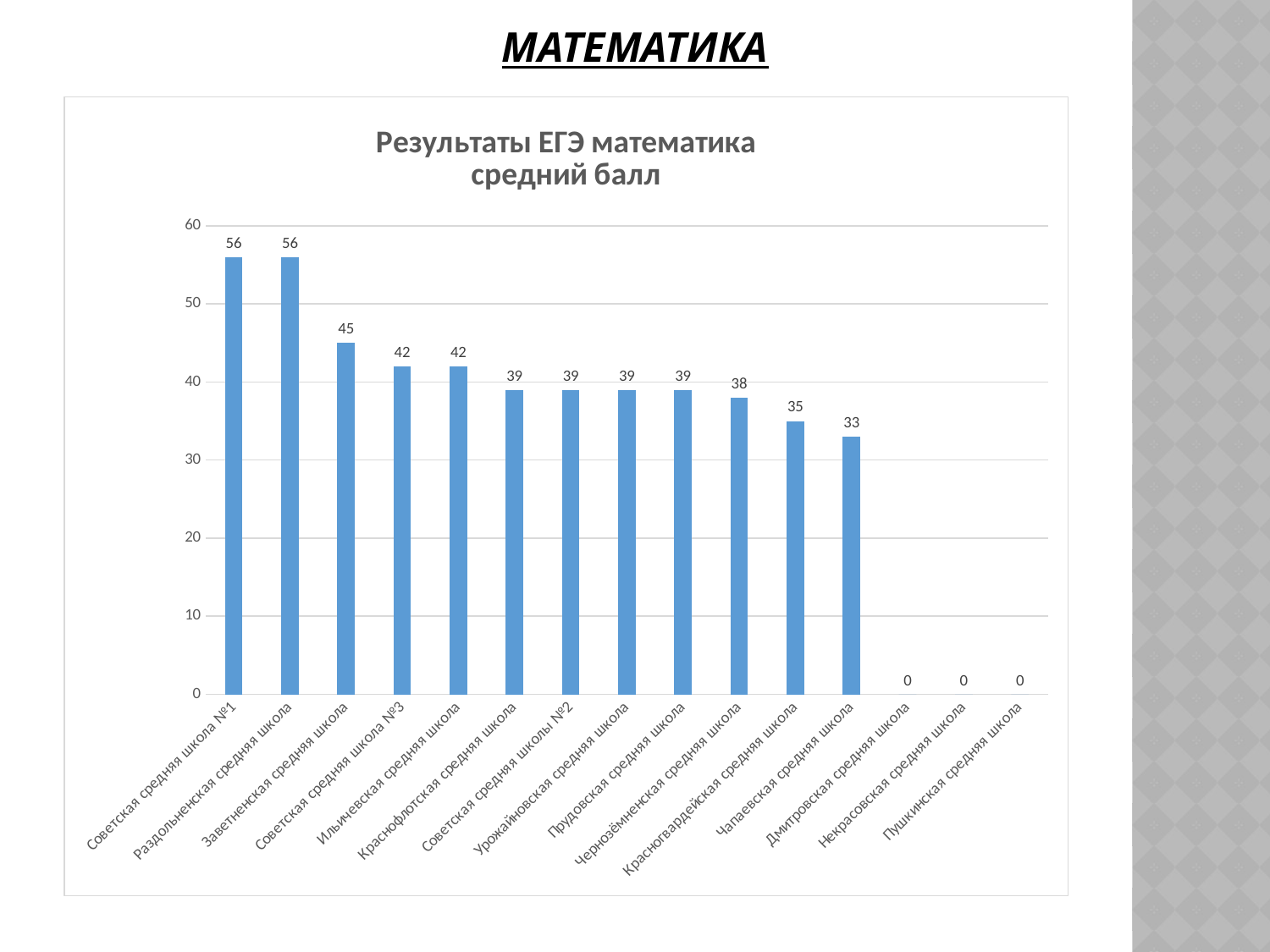
What is the highest value shown in the chart? 56 How many categories (schools) are shown on the x axis? 15 Which is larger, the value for Заветненская средняя школа or the value for Ильичевская средняя школа? Заветненская средняя школа What is the value for Чапаевская средняя школа? 33 What is the value for Чернозёмненская средняя школа? 38 What is the value for Красногвардейская средняя школа? 35 What is the value for Дмитровская средняя школа? 0 What is the title of the chart? Результаты ЕГЭ математика средний балл What is the difference between the values for Советская средняя школа №1 and Чапаевская средняя школа? 23 Is the value for Раздольненская средняя школа greater or less than 50? greater What is the value for Заветненская средняя школа? 45 What type of chart is shown on the slide? bar chart